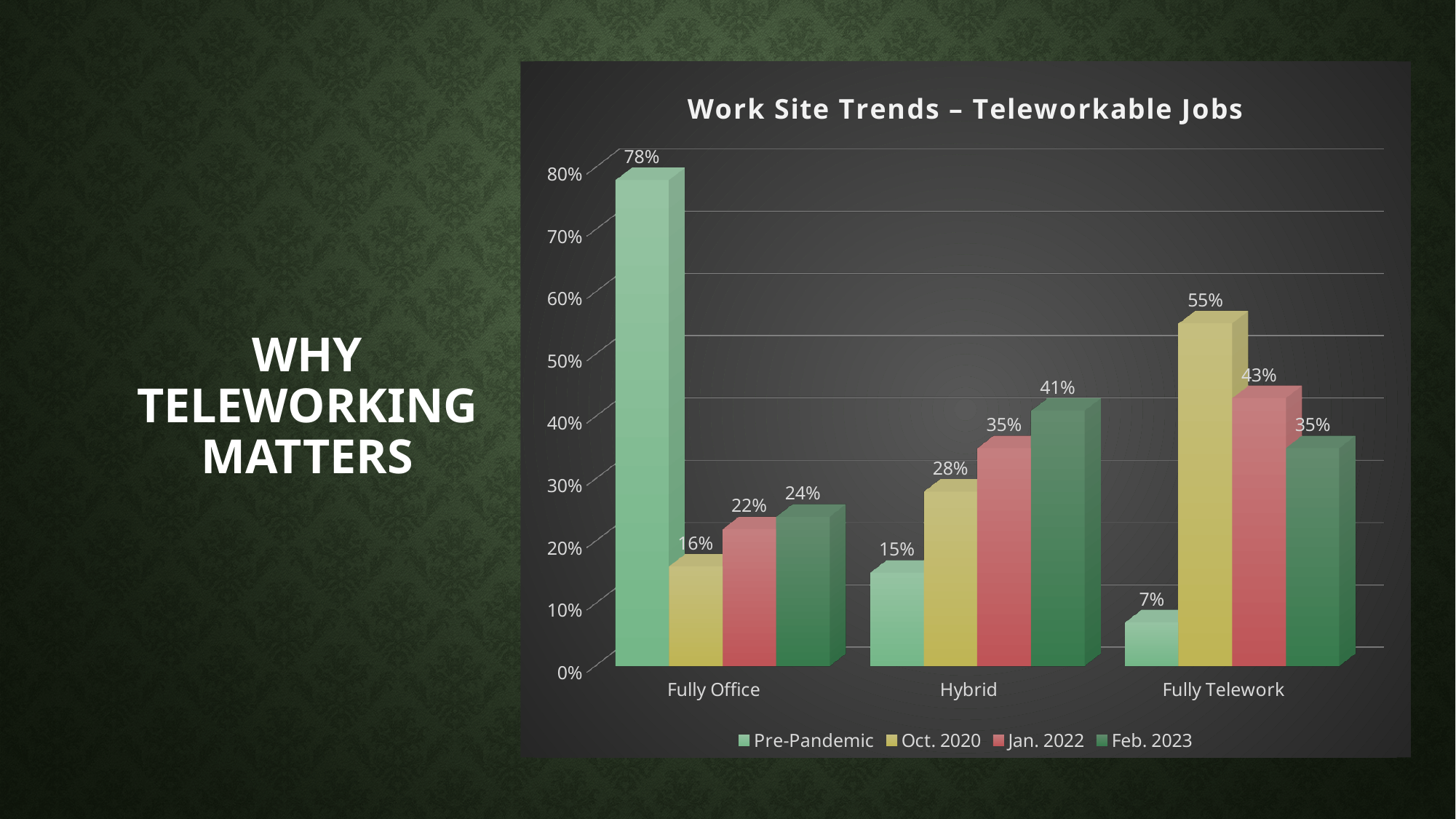
How many series does the legend list? 4 What is the title of the chart? Work Site Trends – Teleworkable Jobs Which category has the lowest Pre-Pandemic value? Fully Telework What is the difference between the Pre-Pandemic and Feb. 2023 values for Fully Office? 54% How many categories are shown on the x axis? 3 What is the Oct. 2020 value for Fully Telework? 55% What kind of chart is shown? Bar chart What is the Pre-Pandemic value for Fully Office? 78% Which is larger for Fully Telework: the Oct. 2020 value or the Feb. 2023 value? Oct. 2020 What is the Feb. 2023 value for Hybrid? 41% Which category has the highest Pre-Pandemic value? Fully Office What is the Jan. 2022 value for Fully Office? 22%